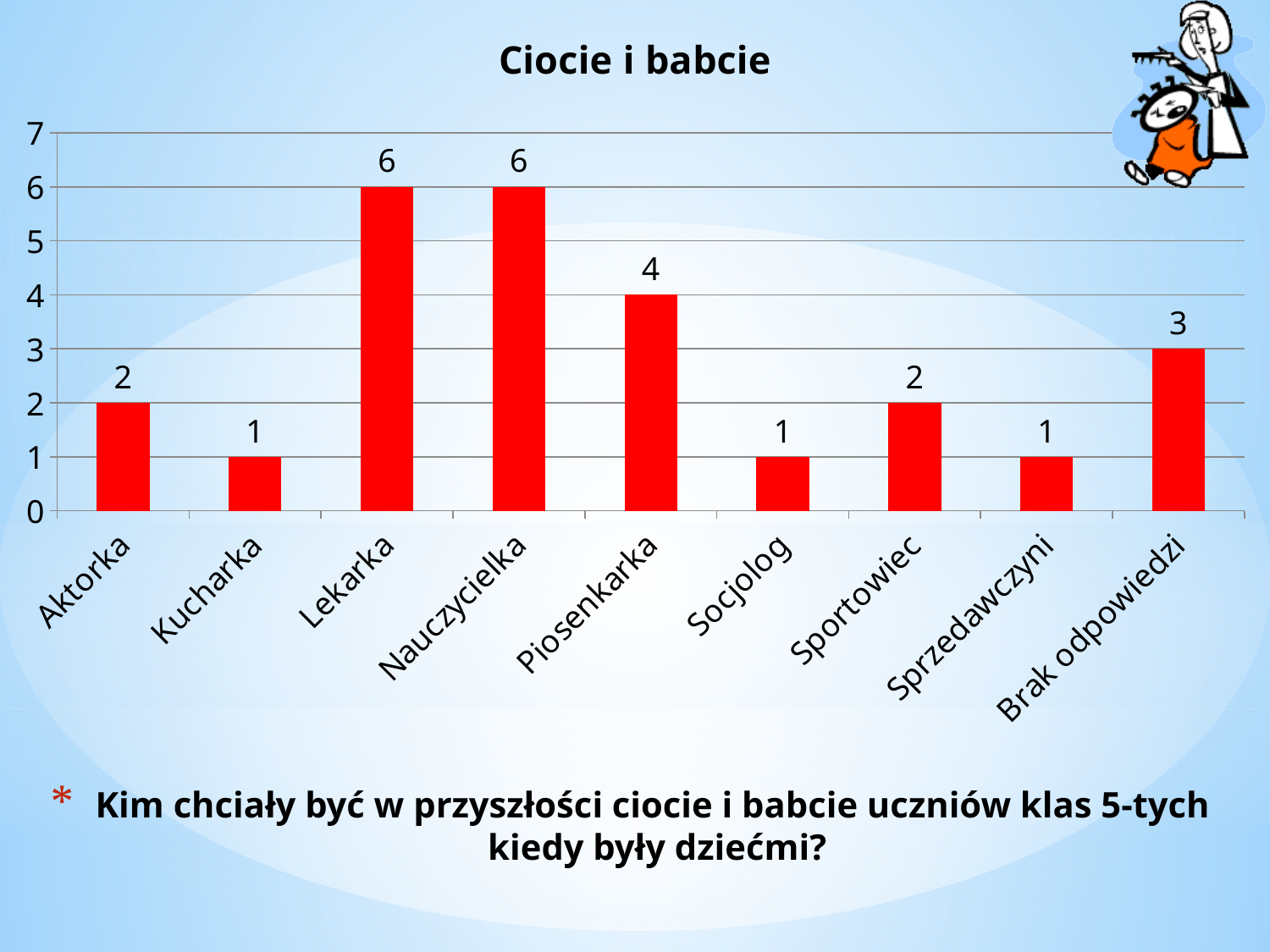
Which categories have the highest value? Lekarka and Nauczycielka What colour are the bars in the chart? red What kind of chart is shown on the slide? bar chart What is the difference between the values for Lekarka and Piosenkarka? 2 What is the value for Brak odpowiedzi? 3 What is the title of the chart? Ciocie i babcie What is the value for Sportowiec? 2 Is the value for Nauczycielka greater or less than 5? greater What is the difference between the values for Piosenkarka and Socjolog? 3 What is the value for Piosenkarka? 4 Which is larger, the value for Aktorka or the value for Brak odpowiedzi? Brak odpowiedzi How many categories are shown on the x axis? 9